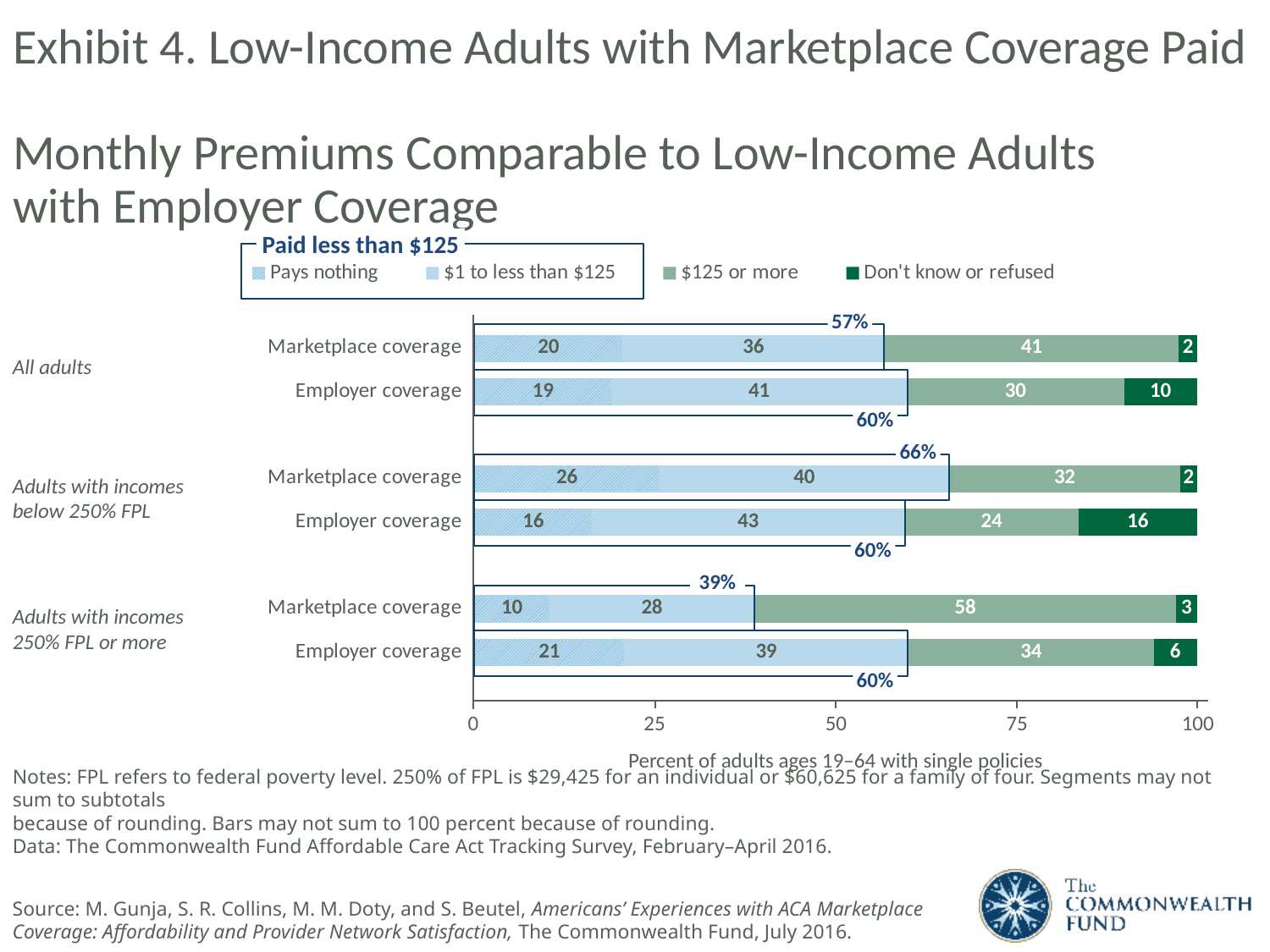
Among all adults, how much larger is the '$1 to less than $125' value for Employer coverage than for Marketplace coverage? 5 Which bar has the lowest 'Pays nothing' value? Marketplace coverage, adults with incomes 250% FPL or more What percentage of all adults with Marketplace coverage pay $125 or more? 41 Among adults with incomes below 250% FPL, what is the difference in the 'Don't know or refused' value between Employer coverage and Marketplace coverage? 14 How many bars are plotted in the chart? 6 How many series does the legend list? 4 Among adults with incomes 250% FPL or more, what share of those with Marketplace coverage pays nothing? 10 What kind of chart is shown on the slide? Stacked bar chart What is the 'Paid less than $125' subtotal for Marketplace coverage among adults with incomes below 250% FPL? 66% Among adults with incomes below 250% FPL, what is the 'Don't know or refused' value for Employer coverage? 16 Among all adults, which has the larger '$125 or more' value: Marketplace coverage or Employer coverage? Marketplace coverage Which bar has the highest '$125 or more' value? Marketplace coverage, adults with incomes 250% FPL or more